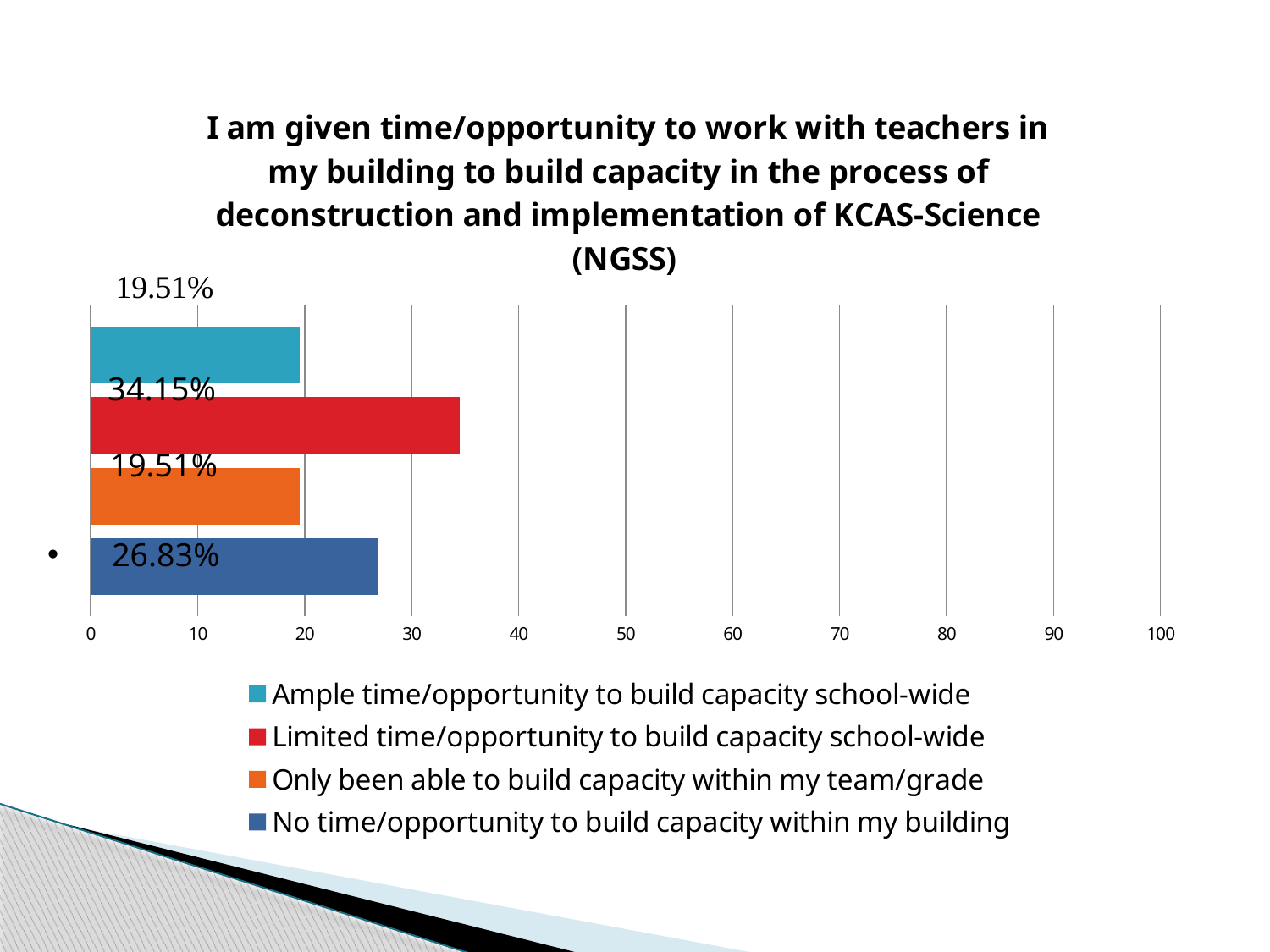
What colour is the bar for 'Only been able to build capacity within my team/grade'? Orange What is the maximum value shown on the horizontal axis? 100 What kind of chart is shown on the slide? Bar chart What percentage of respondents reported no time/opportunity to build capacity within my building? 26.83% What is the total of the four percentages shown on the chart? 100% Which is larger: the value for 'No time/opportunity to build capacity within my building' or the value for 'Only been able to build capacity within my team/grade'? No time/opportunity to build capacity within my building How many series does the legend list? 4 What is the difference in percentage points between 'Limited time/opportunity to build capacity school-wide' and 'No time/opportunity to build capacity within my building'? 7.32 Which response option has the highest percentage? Limited time/opportunity to build capacity school-wide What percentage of respondents reported limited time/opportunity to build capacity school-wide? 34.15% Is the value for 'Limited time/opportunity to build capacity school-wide' greater or less than 30? greater What percentage of respondents reported ample time/opportunity to build capacity school-wide? 19.51%